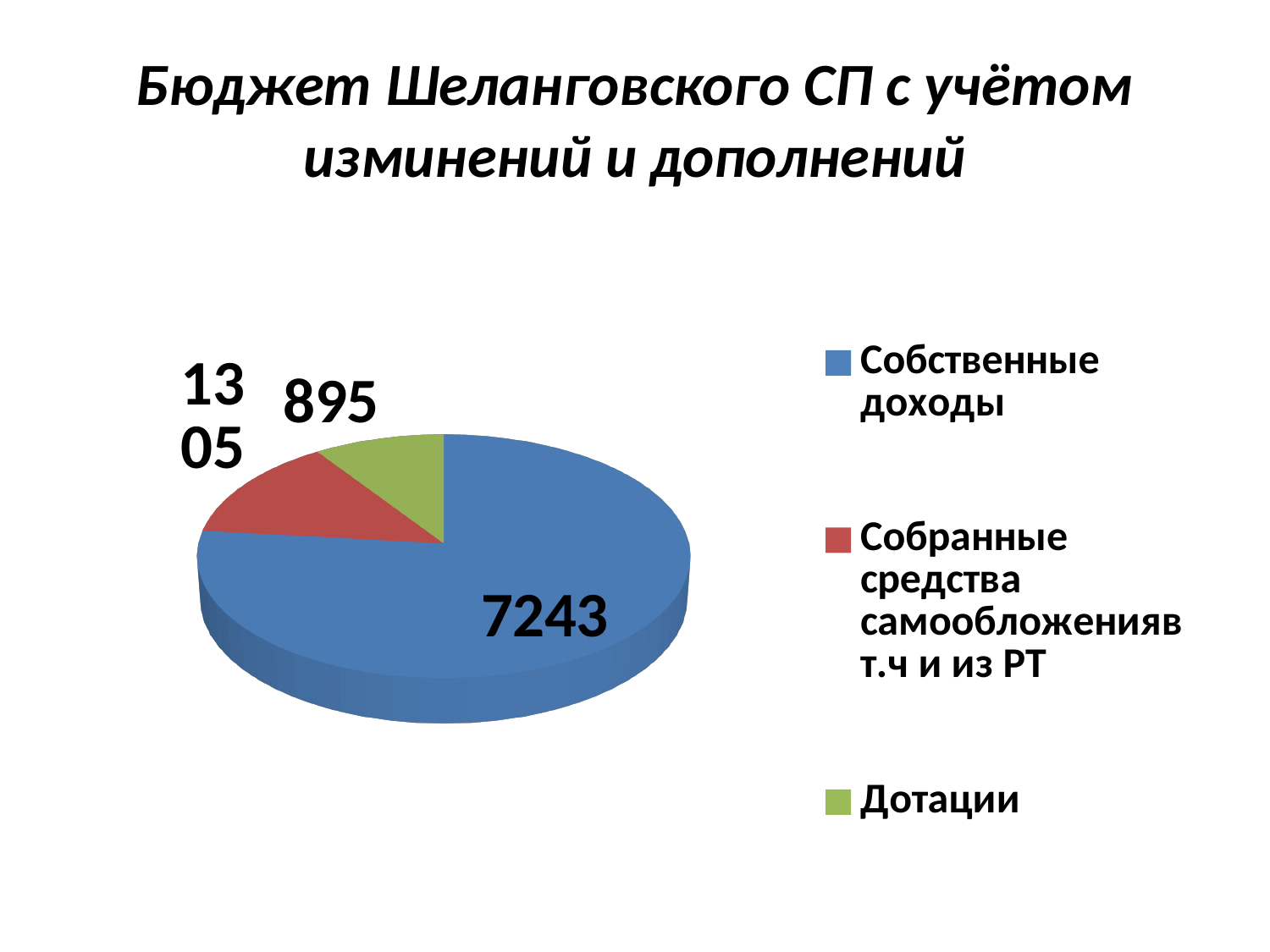
Which category has the largest slice of the pie? Собственные доходы Which is larger, Собранные средства самообложения в т.ч и из РТ or Дотации? Собранные средства самообложения в т.ч и из РТ What is the value for Собственные доходы? 7243 What is the value for Дотации? 895 Which category has the smallest slice of the pie? Дотации What is the total of all slices in the pie chart? 9443 What is the value for Собранные средства самообложения в т.ч и из РТ? 1305 What is the difference between Собранные средства самообложения в т.ч и из РТ and Дотации? 410 How many slices does the pie chart have? 3 What is the difference between Собственные доходы and Дотации? 6348 What type of chart is shown on the slide? Pie chart What is the title of the chart on the slide? Бюджет Шеланговского СП с учётом изминений и дополнений